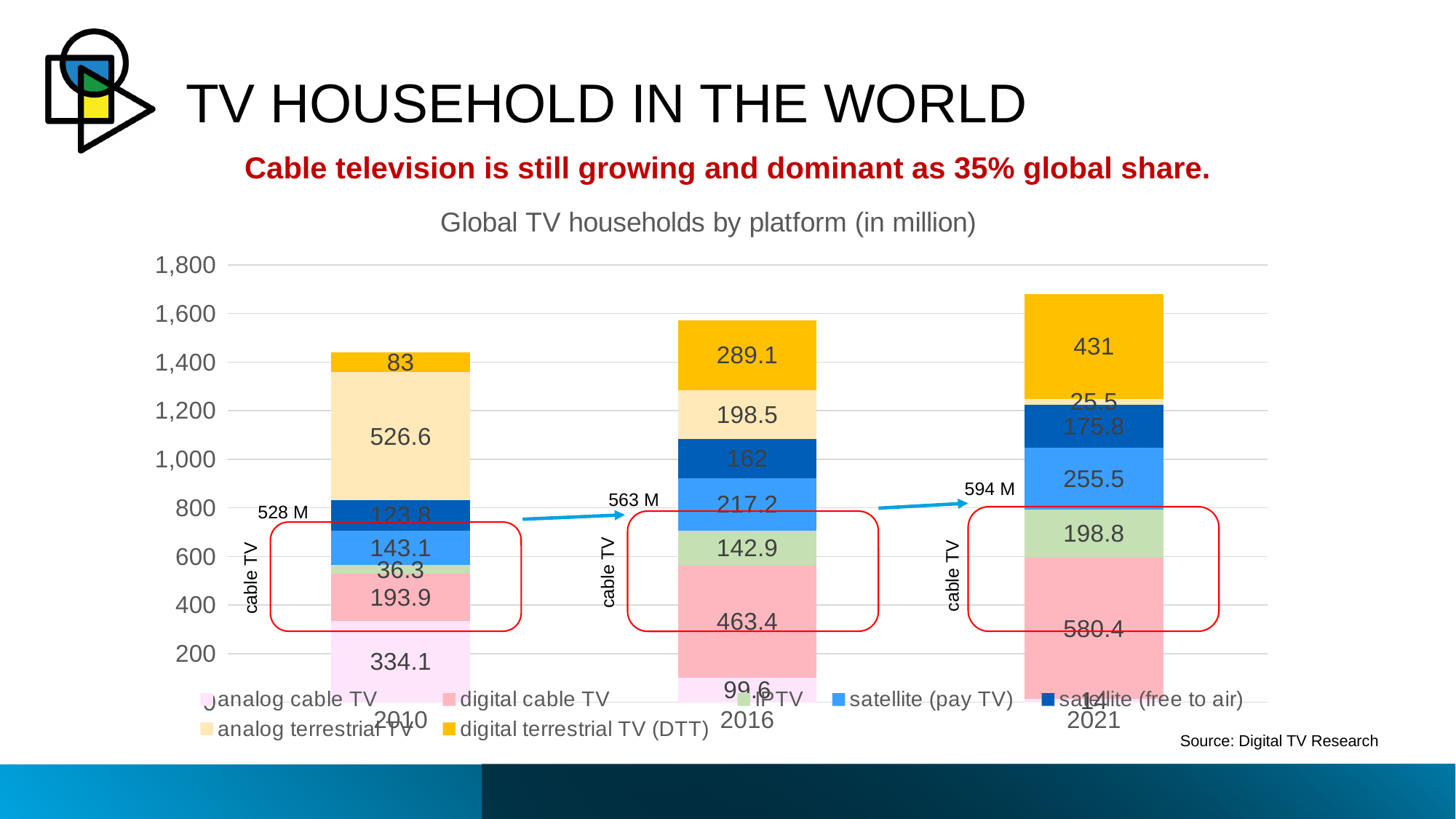
What is the title of the chart? Global TV households by platform (in million) By how much did digital terrestrial TV (DTT) increase from 2010 to 2021? 348 Does the value for analog terrestrial TV rise or fall from 2010 to 2021? Fall How many series does the chart legend list? 7 What is the total of the stacked bar for 2010? 1440.8 What is the value for analog terrestrial TV in 2010? 526.6 What is the value for IPTV in 2021? 198.8 What is the value for digital cable TV in 2016? 463.4 In 2021, which is larger: satellite (pay TV) or satellite (free to air)? satellite (pay TV) How many years are shown on the x axis of the chart? 3 What is the value for digital terrestrial TV (DTT) in 2021? 431 What kind of chart is shown on the slide? Stacked bar chart